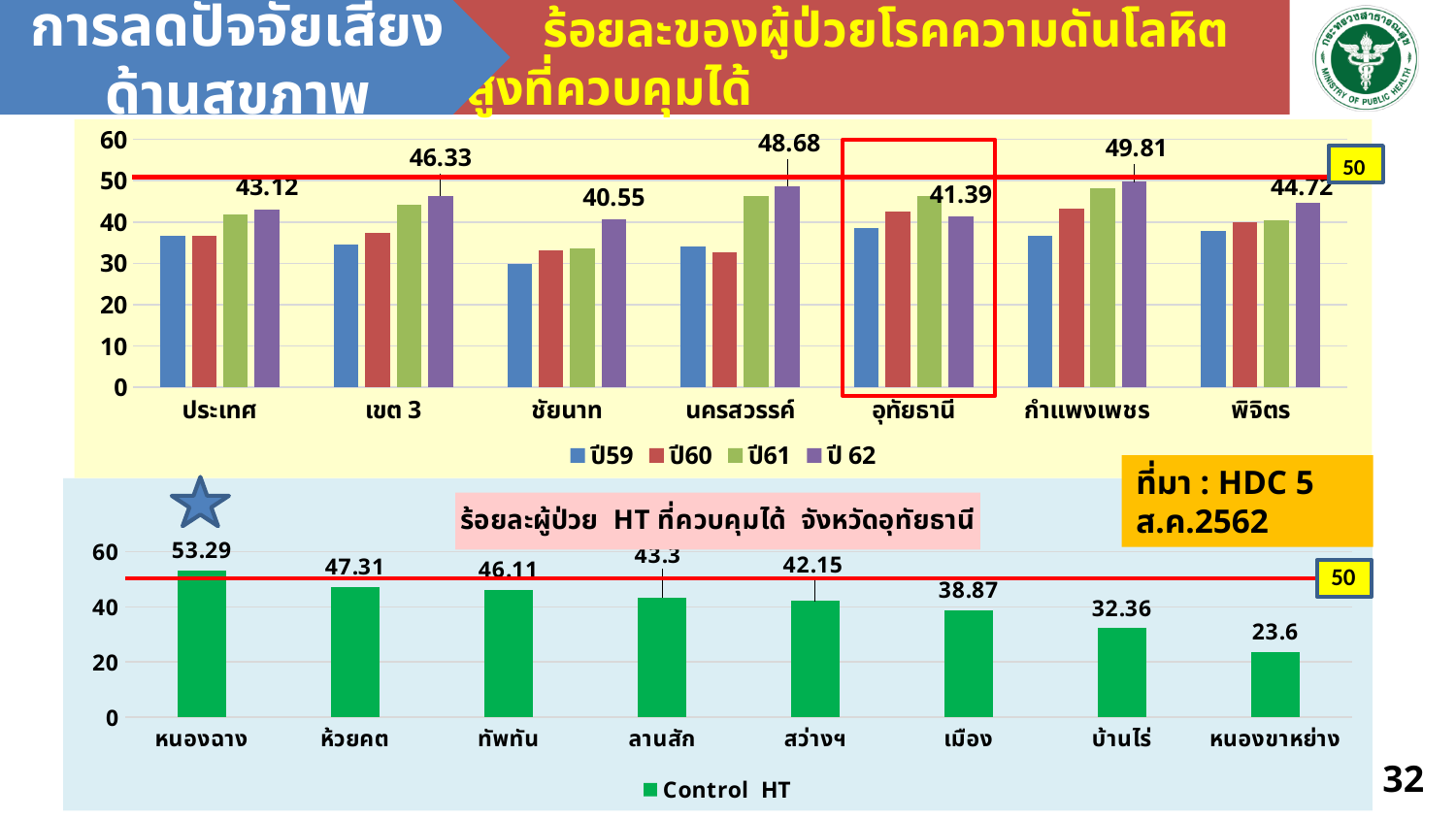
In the top chart, what is the ปี 62 value for กำแพงเพชร? 49.81 In the top chart, which category has the highest ปี 62 value? กำแพงเพชร In the bottom chart, do the values rise or fall from left to right? fall In the top chart, how many series does the legend list? 4 In the bottom chart, what is the difference between the values for หนองฉาง and ห้วยคต? 5.98 In the bottom chart, what is the value for หนองขาหย่าง? 23.6 In the top chart, what is the difference between the ปี 62 values for นครสวรรค์ and ชัยนาท? 8.13 In the top chart, what is the ปี 62 value for อุทัยธานี? 41.39 In the bottom chart, how many categories are shown? 8 In the bottom chart, which category has the highest value? หนองฉาง In the top chart, is the ปี59 value for ประเทศ greater or less than 40? less In the top chart, which category has the lowest ปี 62 value? ชัยนาท